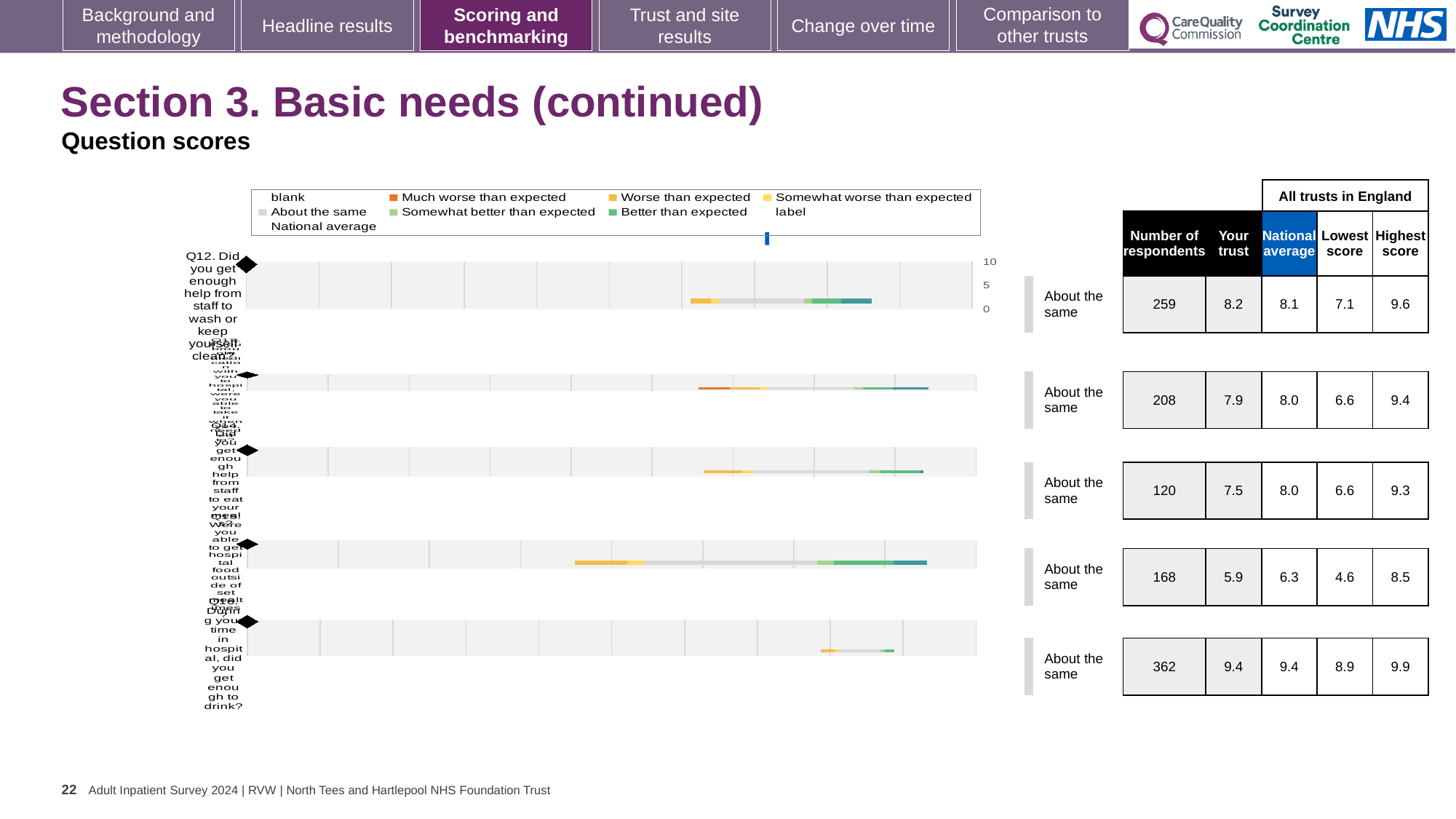
How many respondents answered Q12 (help from staff to wash or keep yourself clean)? 259 What is the national average score for Q12 (help from staff to wash or keep yourself clean)? 8.1 What benchmark category is shown for every question bar on this slide? About the same Which question bar has the highest 'Your trust' score? the fifth bar (9.4) What is the 'Your trust' score for the fifth (bottom) question bar? 9.4 What type of chart is used to show the question scores on this slide? bar chart How many question bars are plotted in the chart? 5 In the chart legend, which colour represents 'Much worse than expected'? orange What is the 'Your trust' score for Q12 (Did you get enough help from staff to wash or keep yourself clean?)? 8.2 For Q12, is the 'Your trust' score higher or lower than the national average? higher Which question bar has the lowest 'Your trust' score? the fourth bar (5.9) For Q12, what is the difference between the highest score (9.6) and the lowest score (7.1) across all trusts in England? 2.5